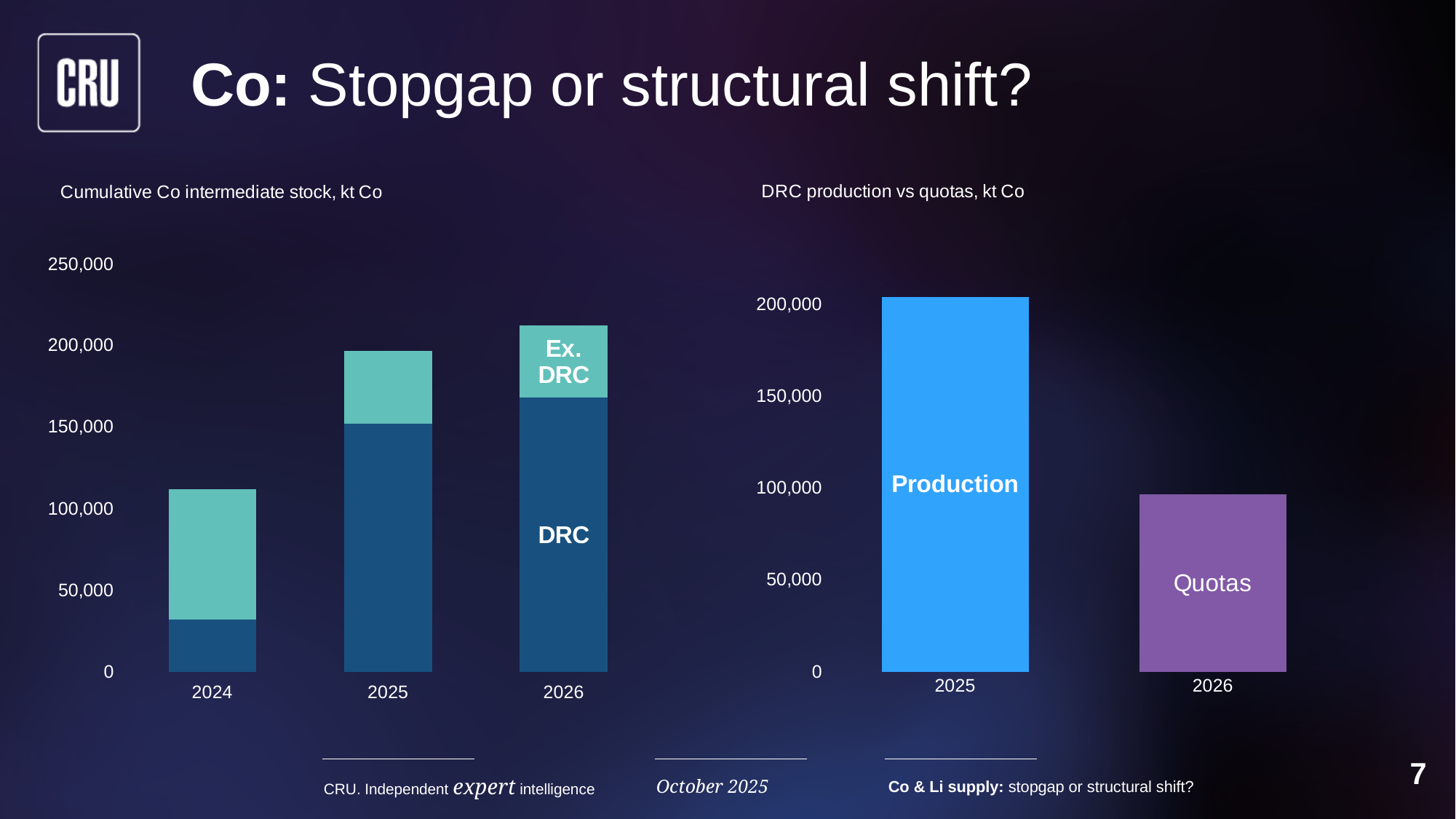
What kind of chart is the 'Cumulative Co intermediate stock, kt Co' chart on the left? bar chart In the 'Cumulative Co intermediate stock, kt Co' chart, is the total value for 2024 greater or less than 150,000? less In the 'Cumulative Co intermediate stock, kt Co' chart, is the DRC segment for 2024 greater or less than 50,000? less In the 'DRC production vs quotas, kt Co' chart, how many bars are plotted? 2 In the 'Cumulative Co intermediate stock, kt Co' chart, what are the two segments of the stacked bars labelled? DRC and Ex. DRC In the 'DRC production vs quotas, kt Co' chart, is the Quotas value for 2026 greater or less than 100,000? less In the 'Cumulative Co intermediate stock, kt Co' chart, how many years are shown on the x axis? 3 In the 'Cumulative Co intermediate stock, kt Co' chart, do the total stock values rise or fall from 2024 to 2026? rise In the 'Cumulative Co intermediate stock, kt Co' chart, which year has the larger total stock, 2024 or 2025? 2025 In the 'DRC production vs quotas, kt Co' chart, which bar is taller, Production 2025 or Quotas 2026? Production 2025